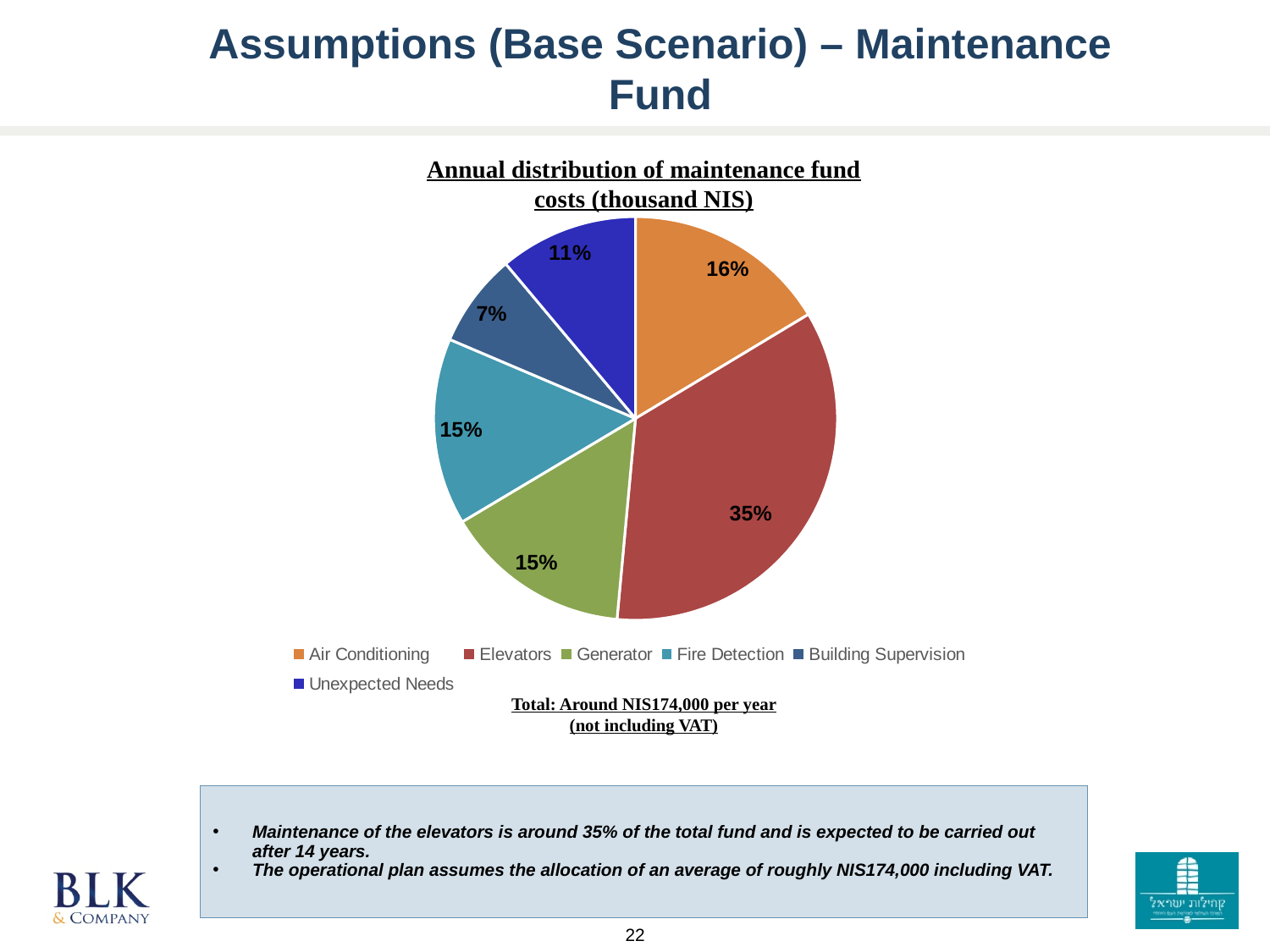
What share of the pie does Generator account for? 15% What share of the pie does Elevators account for? 35% What is the title of the chart? Annual distribution of maintenance fund costs (thousand NIS) Which is larger, the share for Unexpected Needs or the share for Building Supervision? Unexpected Needs Which category has the smallest share of the pie? Building Supervision What type of chart is shown on the slide? Pie chart What share of the pie does Air Conditioning account for? 16% What is the difference in percentage points between the Elevators share and the Air Conditioning share? 19 How many categories does the pie chart show? 6 Which category has the largest share of the pie? Elevators